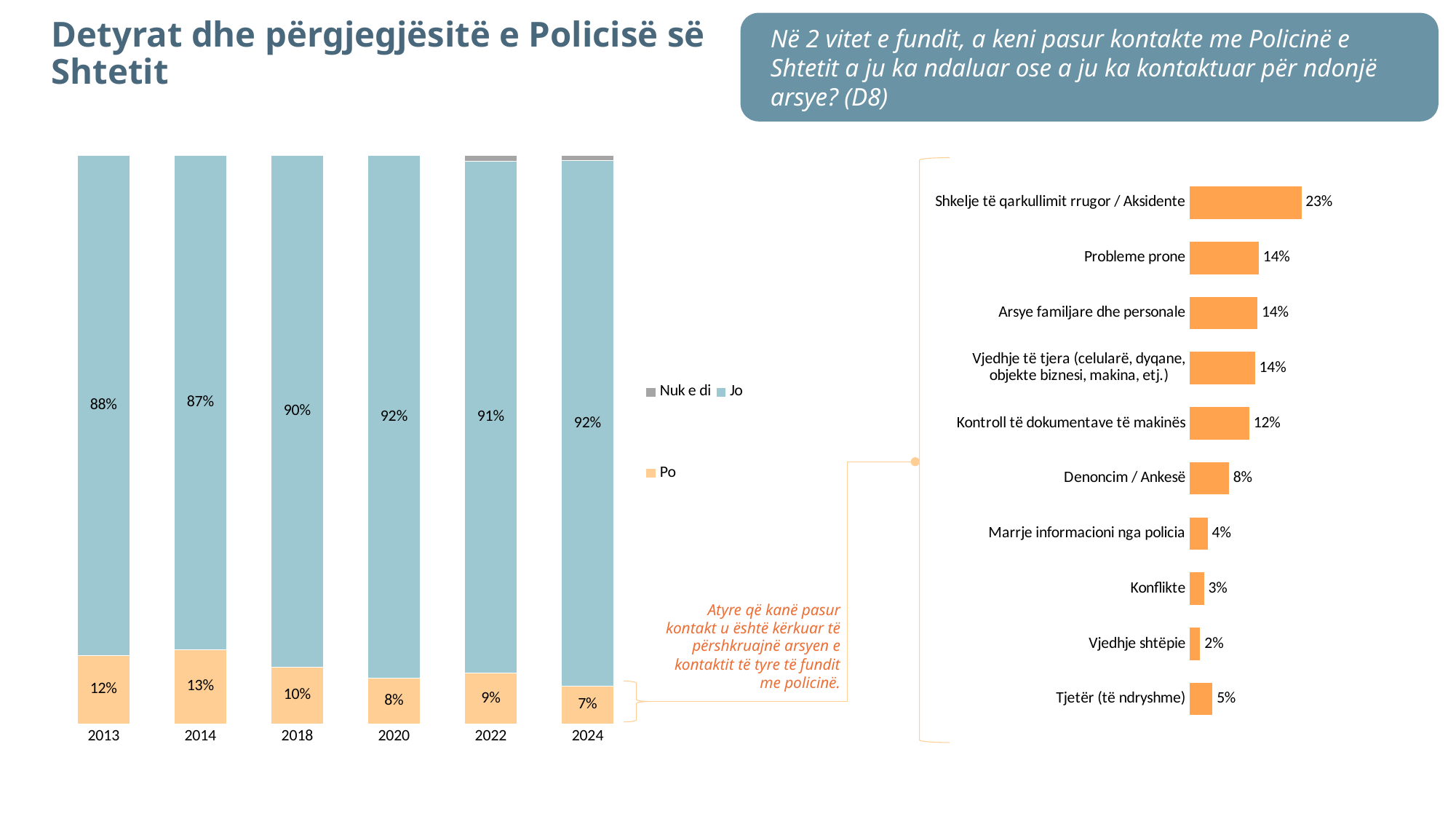
In the right bar chart, how many categories are shown? 10 In the left stacked bar chart, which year has the highest 'Po' value? 2014 In the left stacked bar chart, what is the 'Jo' value for 2020? 92% In the right bar chart, which category has the lowest value? Vjedhje shtëpie In the left stacked bar chart, what is the 'Po' value for 2013? 12% In the left stacked bar chart, how many series does the legend list? 3 What kind of chart is the chart on the right side of the slide? Bar chart In the left stacked bar chart, how many years are shown on the x axis? 6 In the left stacked bar chart, which year has the lowest 'Po' value? 2024 In the right bar chart, what is the value for 'Shkelje të qarkullimit rrugor / Aksidente'? 23% In the right bar chart, which is larger: 'Denoncim / Ankesë' or 'Tjetër (të ndryshme)'? Denoncim / Ankesë In the left stacked bar chart, what is the difference between the 'Po' values for 2014 and 2024? 6%